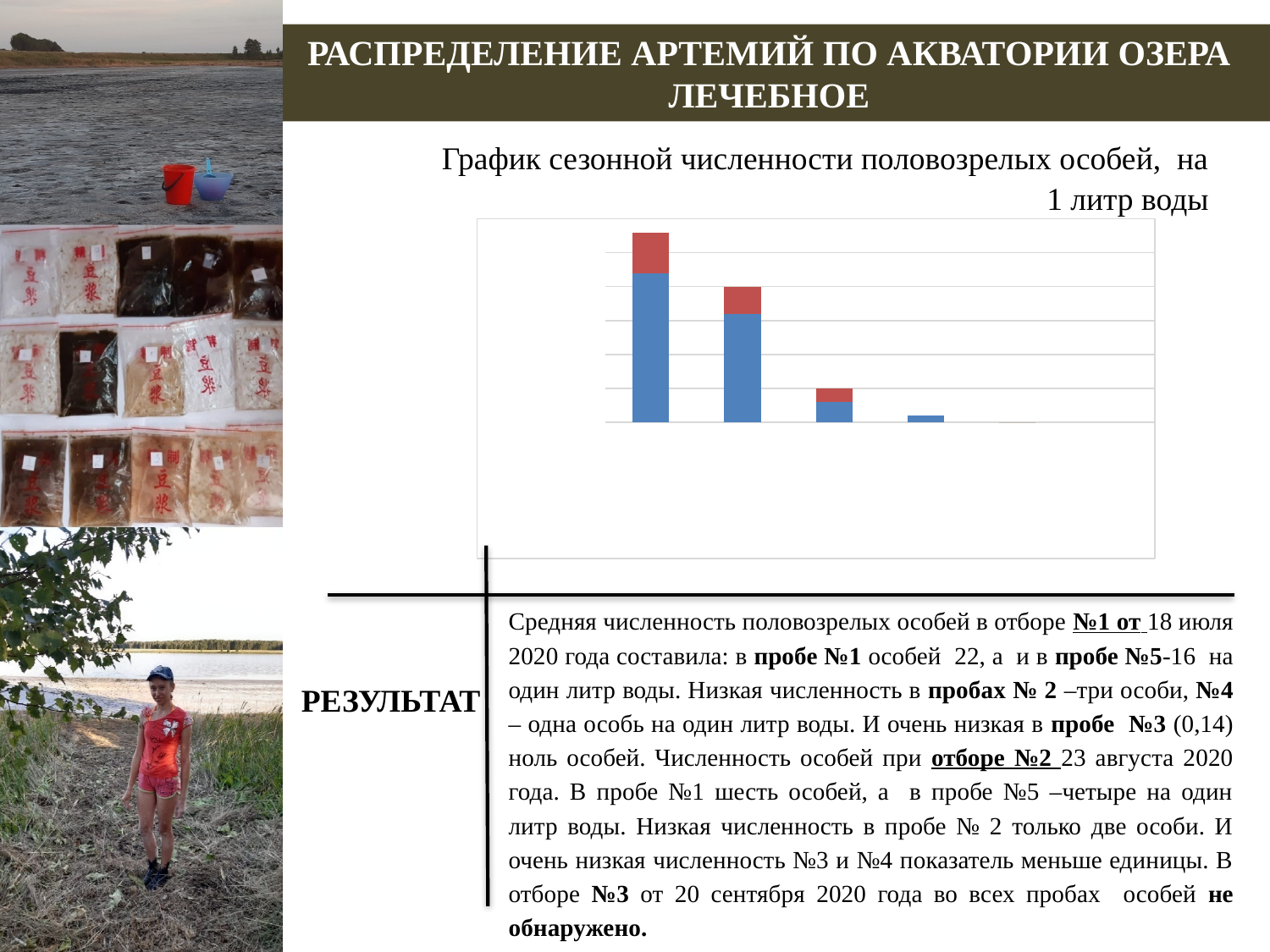
What two colours are used for the stacked segments of the bars? blue and red What kind of chart is shown on the slide? bar chart Which bar is the tallest: the leftmost bar or the rightmost visible bar? the leftmost bar Do the bar heights rise or fall from left to right across the chart? fall Is the leftmost bar taller or shorter than the second bar from the left? taller What is the title of the chart on the slide? График сезонной численности половозрелых особей, на 1 литр воды